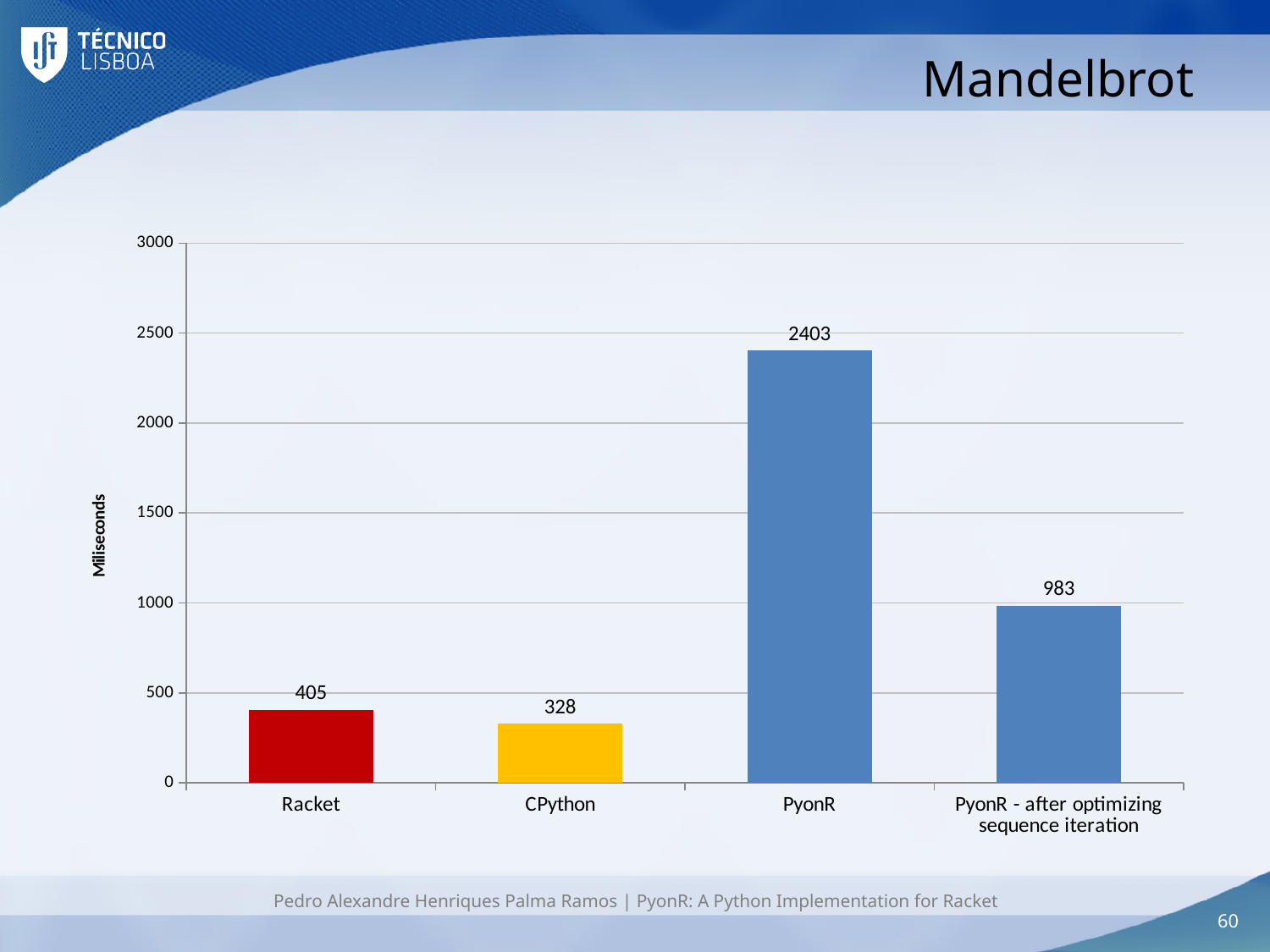
Which category has the highest value? PyonR What is the difference between the values for PyonR and PyonR - after optimizing sequence iteration? 1420 What is the value for Racket? 405 How many categories are shown on the x axis? 4 Which is larger, the value for Racket or the value for CPython? Racket What is the value for PyonR - after optimizing sequence iteration? 983 Is the value for PyonR greater or less than 2000? greater What is the difference between the values for Racket and CPython? 77 Which category has the lowest value? CPython What kind of chart is shown on the slide? bar chart What is the value for PyonR? 2403 What is the value for CPython? 328